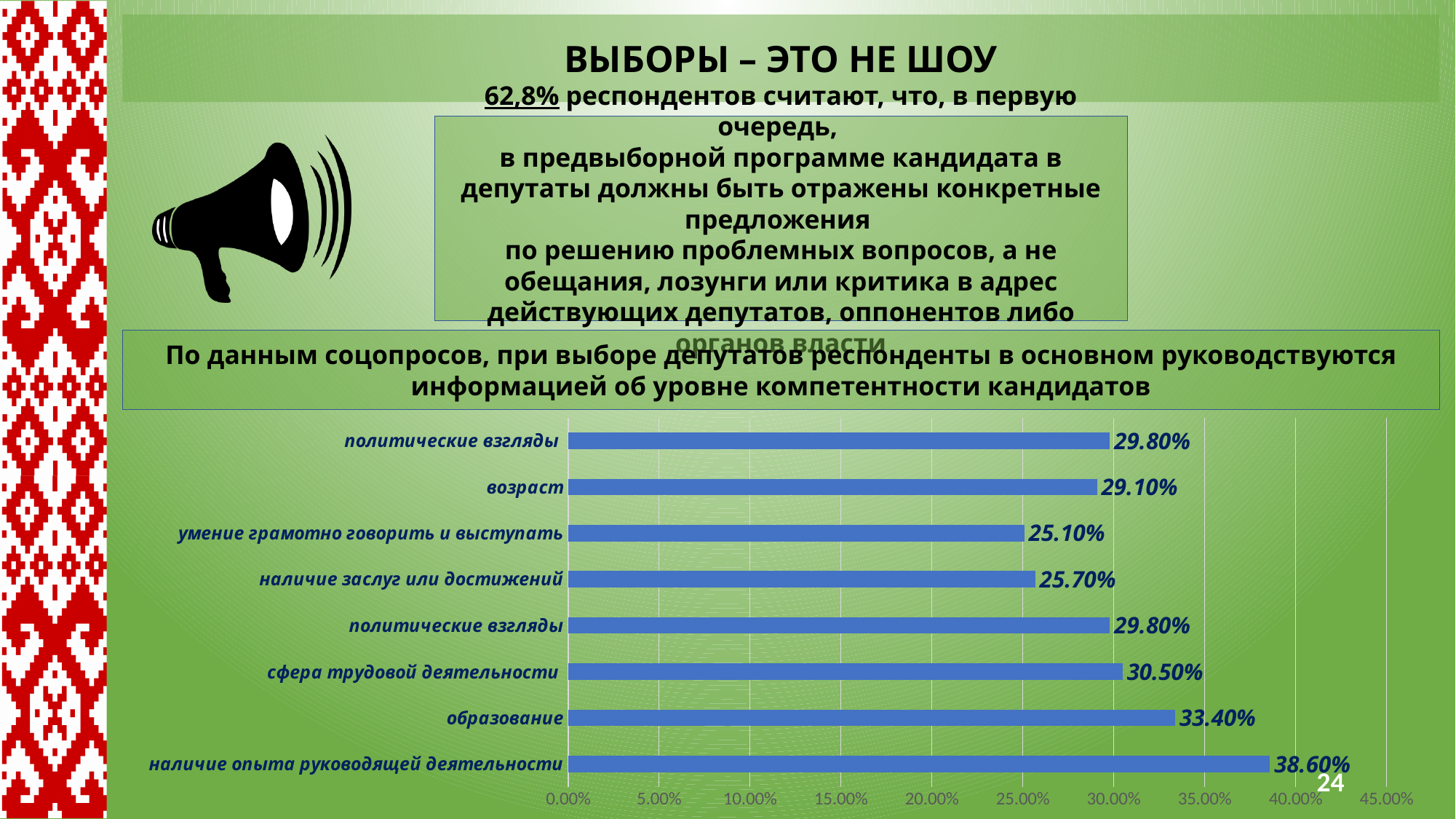
How many categories (bars) does the chart show? 8 Which category has the highest value? наличие опыта руководящей деятельности What is the value for 'умение грамотно говорить и выступать'? 25.10% What is the value for 'возраст'? 29.10% Which category has the lowest value? умение грамотно говорить и выступать What kind of chart is shown on the slide? bar chart What is the value for 'наличие опыта руководящей деятельности'? 38.60% Is the value for 'образование' greater or less than 35.00%? less What is the value for 'сфера трудовой деятельности'? 30.50% Which is larger: the value for 'наличие заслуг или достижений' or the value for 'сфера трудовой деятельности'? сфера трудовой деятельности What is the difference between the values for 'наличие опыта руководящей деятельности' and 'образование'? 5.20% What is the value for 'образование'? 33.40%